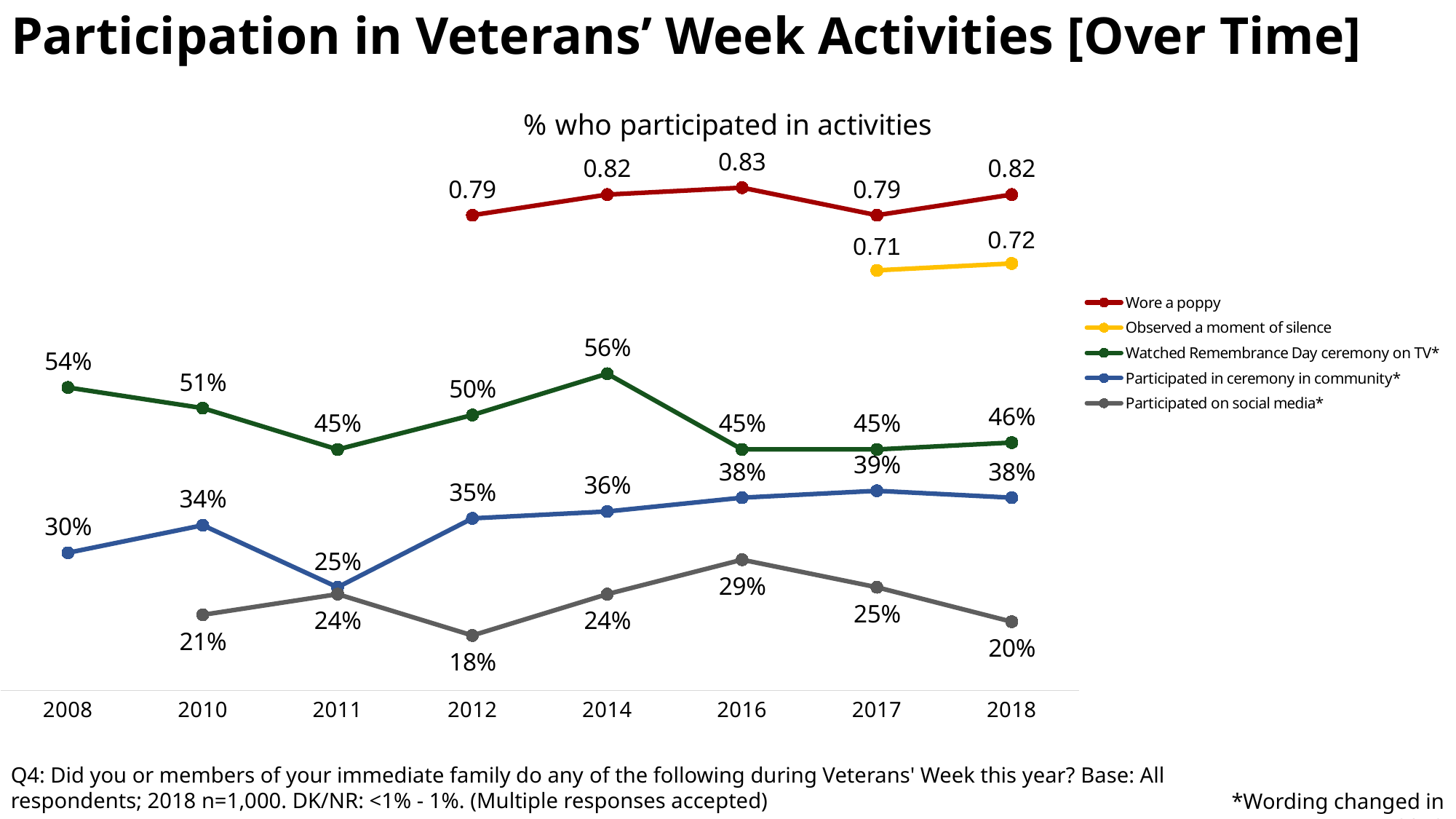
What is the value for "Participated on social media" in 2012? 18% What kind of chart is shown on the slide? Line chart How many series does the legend list? 5 In which year was "Participated on social media" at its lowest? 2012 Did "Participated in ceremony in community" rise or fall from 2012 to 2017? Rise In 2017, which was higher: "Watched Remembrance Day ceremony on TV" or "Participated in ceremony in community"? Watched Remembrance Day ceremony on TV What is the value for "Observed a moment of silence" in 2018? 0.72 What is the value for "Wore a poppy" in 2016? 0.83 What percentage watched the Remembrance Day ceremony on TV in 2014? 56% By how many percentage points did "Participated in ceremony in community" change from 2008 to 2018? 8 percentage points How many years are shown on the x axis? 8 In which year was "Watched Remembrance Day ceremony on TV" at its highest? 2014